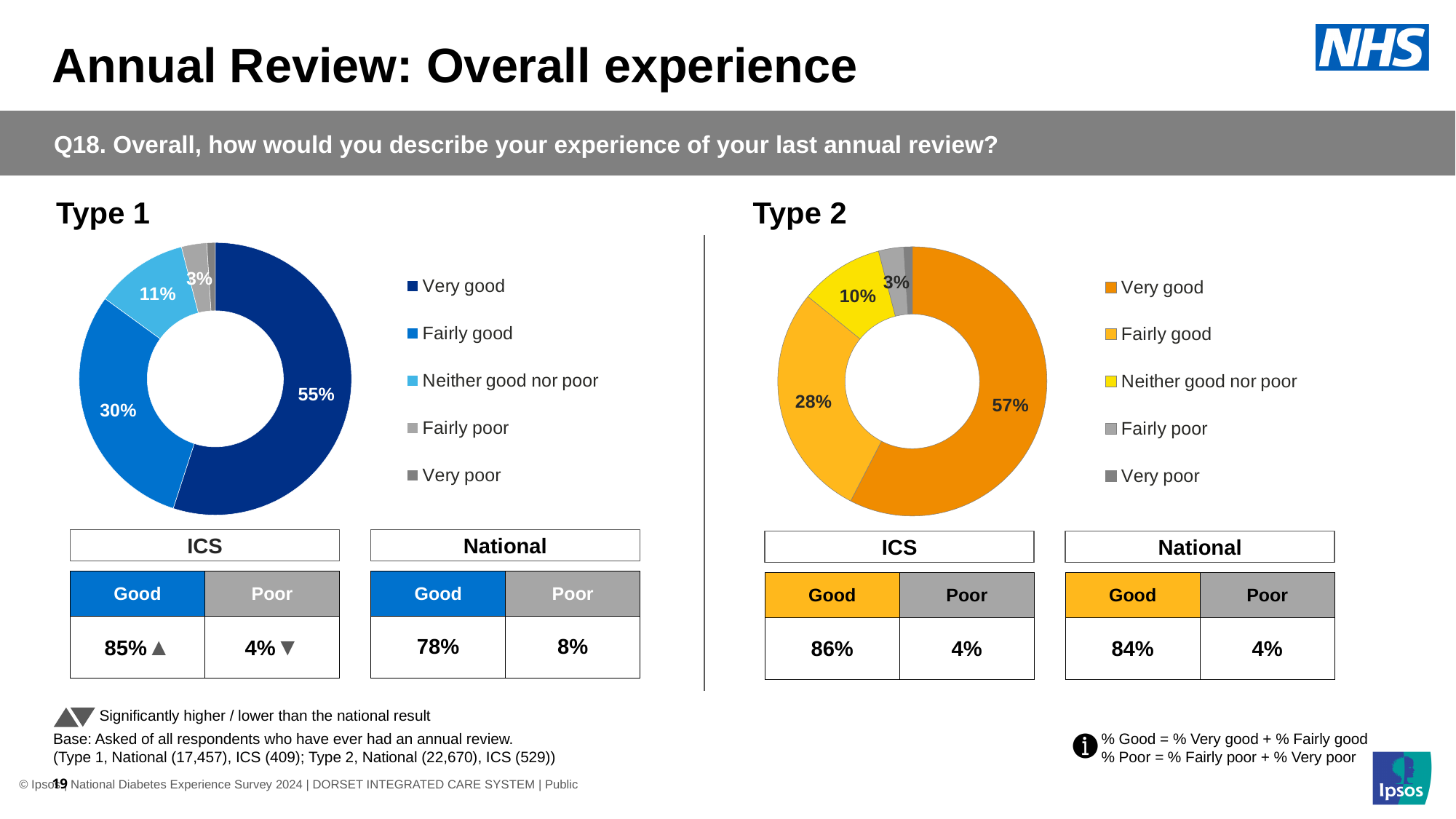
In the Type 1 chart, what percentage of respondents said Neither good nor poor? 11% In the Type 1 chart, which is larger: Fairly good or Neither good nor poor? Fairly good In the Type 2 chart, what is the difference between the Very good and Neither good nor poor shares? 47 percentage points In the Type 1 chart, what is the difference between the Very good and Fairly good shares? 25 percentage points In the Type 2 chart, what colour represents Neither good nor poor? Yellow What kind of chart is used for Type 2? Donut (pie) chart In the Type 2 chart, which category has the largest share? Very good In the Type 2 chart, what percentage of respondents said their experience was Fairly good? 28% Which is larger: the Very good share in the Type 1 chart or the Very good share in the Type 2 chart? Type 2 In the Type 2 chart, what percentage of respondents said Fairly poor? 3% In the Type 1 chart, what percentage of respondents said their experience was Very good? 55% How many categories does the legend of the Type 1 chart list? 5